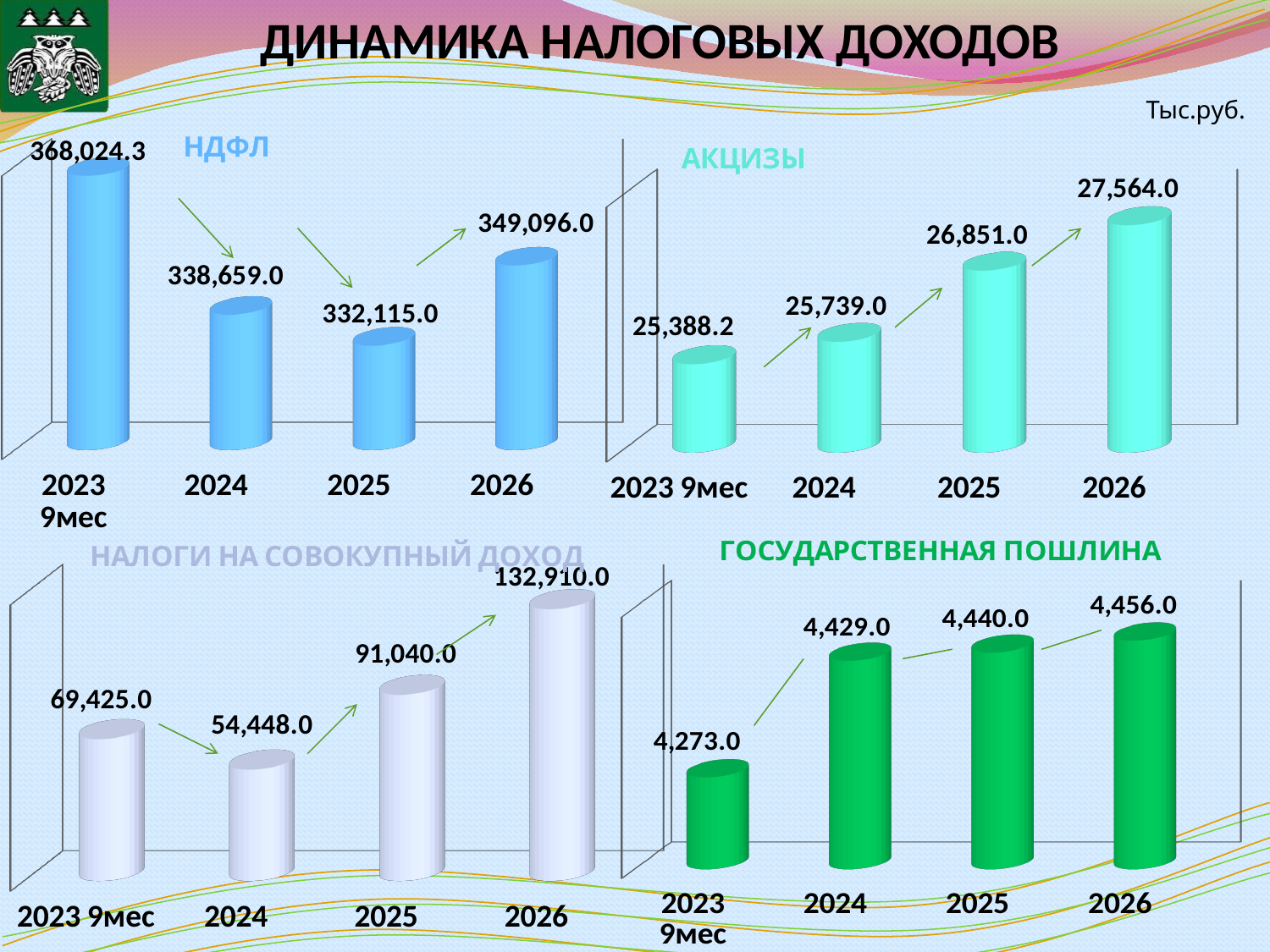
In the НДФЛ chart, what is the difference between the 2026 and 2025 values? 16,981.0 In the НАЛОГИ НА СОВОКУПНЫЙ ДОХОД chart, which year has the highest value? 2026 What kind of chart is the НДФЛ chart? bar chart How many categories are shown in the ГОСУДАРСТВЕННАЯ ПОШЛИНА chart? 4 In the АКЦИЗЫ chart, what is the difference between the 2026 and 2025 values? 713.0 In the НДФЛ chart, what is the value for 2023 9мес? 368,024.3 In the НДФЛ chart, which year has the lowest value? 2025 In the АКЦИЗЫ chart, what is the value for 2025? 26,851.0 In the НАЛОГИ НА СОВОКУПНЫЙ ДОХОД chart, what is the value for 2026? 132,910.0 In the НАЛОГИ НА СОВОКУПНЫЙ ДОХОД chart, which is larger, the value for 2023 9мес or the value for 2024? 2023 9мес In the ГОСУДАРСТВЕННАЯ ПОШЛИНА chart, what is the value for 2024? 4,429.0 In the АКЦИЗЫ chart, do the values rise or fall from 2023 9мес to 2026? rise